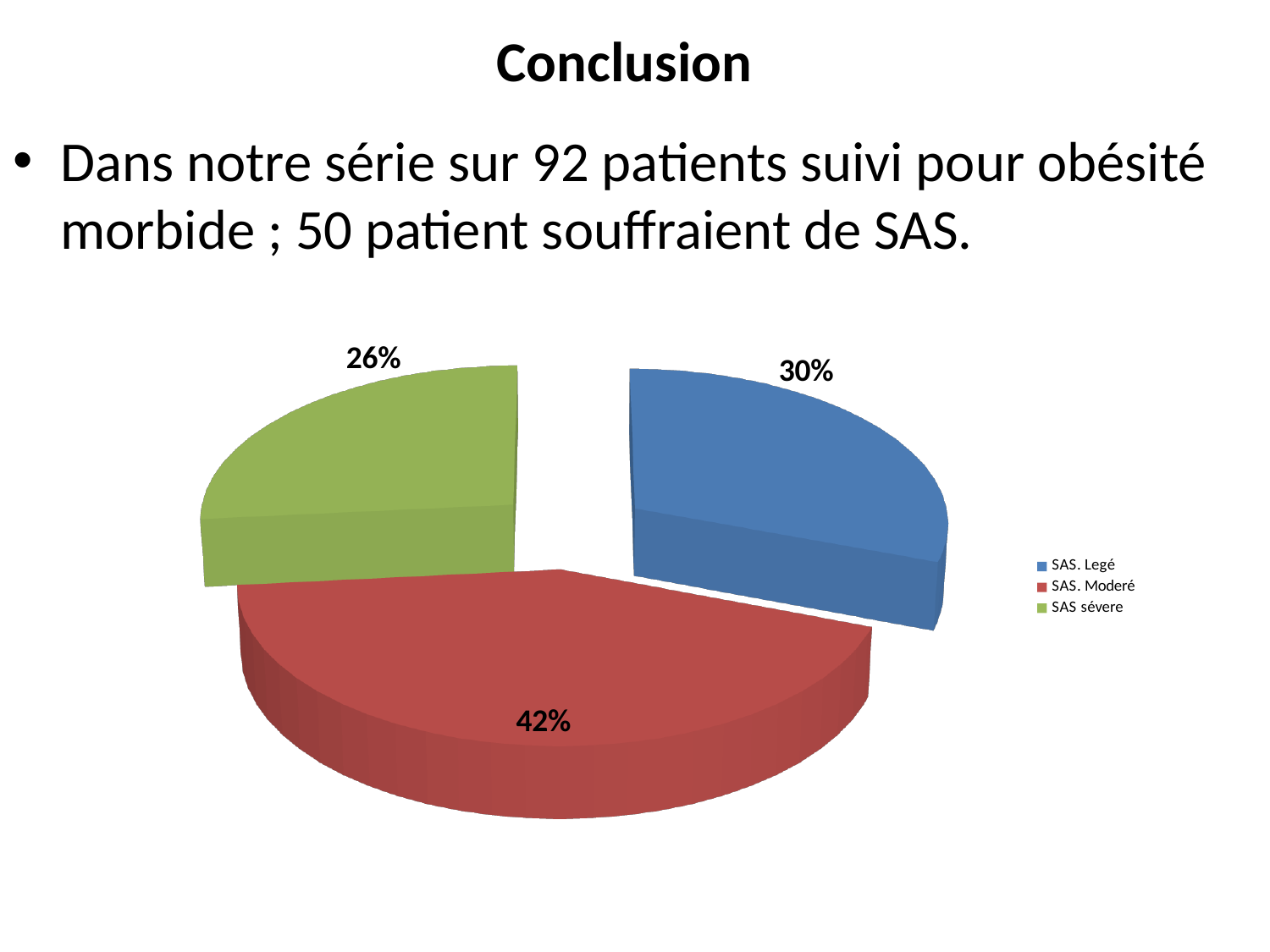
What kind of chart is shown on the slide? pie chart Which is larger, the share for SAS. Legé or the share for SAS. Moderé? SAS. Moderé What is the difference in percentage points between SAS. Legé and SAS sévere? 4 What share of the pie does SAS sévere represent? 26% What share of the pie does SAS. Moderé represent? 42% How many slices does the pie chart have? 3 Which category has the smallest slice of the pie? SAS sévere What is the difference in percentage points between SAS. Moderé and SAS sévere? 16 How many entries does the legend list? 3 Which category has the largest slice of the pie? SAS. Moderé What colour is the slice for SAS sévere? green What share of the pie does SAS. Legé represent? 30%